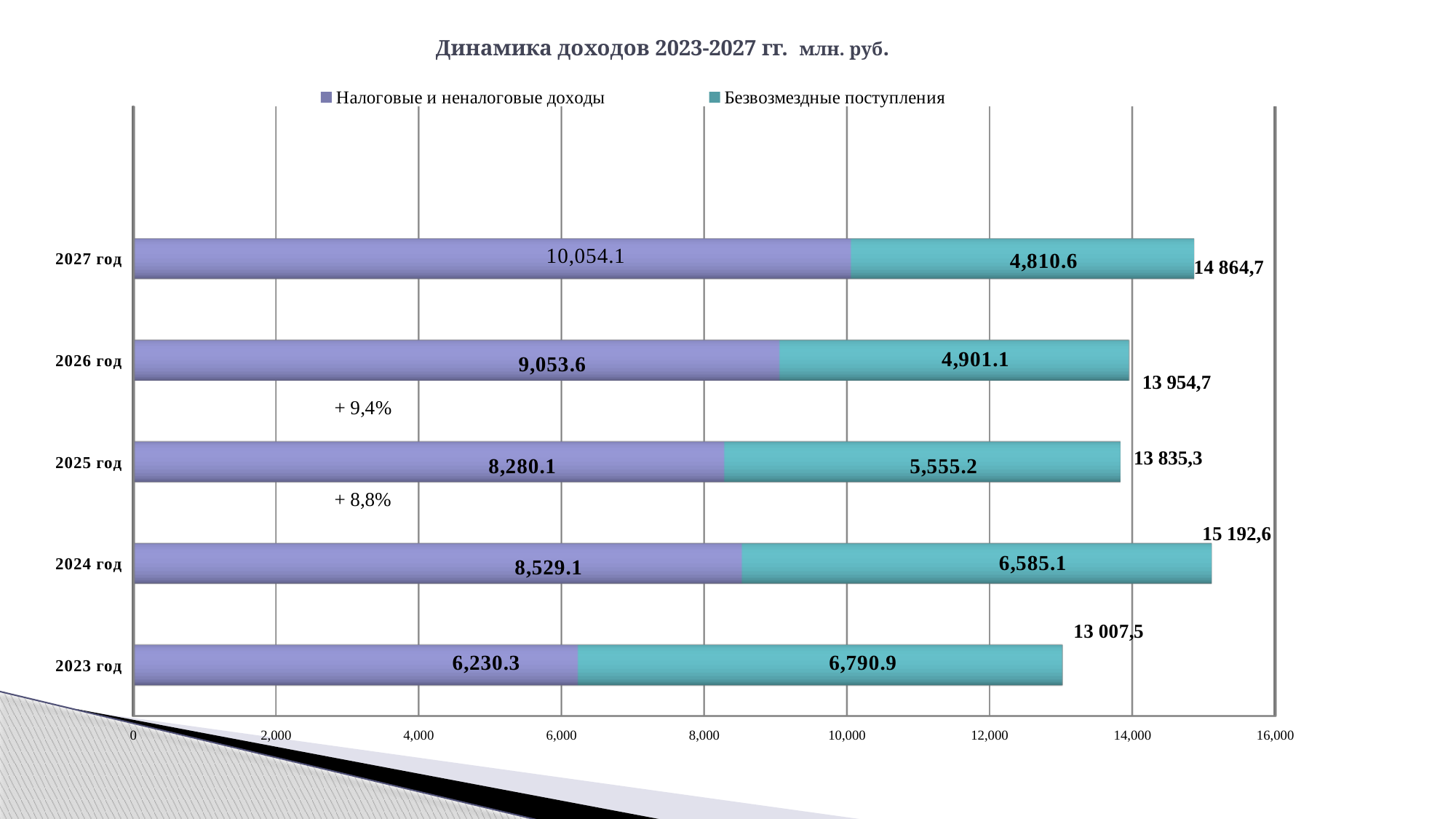
Which year has the lowest value for Безвозмездные поступления? 2027 год What is the title of the chart? Динамика доходов 2023-2027 гг. млн. руб. What is the value of Безвозмездные поступления for 2023 год? 6,790.9 What is the value of Безвозмездные поступления for 2025 год? 5,555.2 How many years are shown on the chart? 5 What is the difference between Налоговые и неналоговые доходы for 2026 год and 2025 год? 773.5 What kind of chart is shown on the slide? Stacked bar chart How many series does the legend list? 2 Which year has the highest value for Налоговые и неналоговые доходы? 2027 год What is the value of Налоговые и неналоговые доходы for 2027 год? 10,054.1 Which is larger for 2023 год: Налоговые и неналоговые доходы or Безвозмездные поступления? Безвозмездные поступления